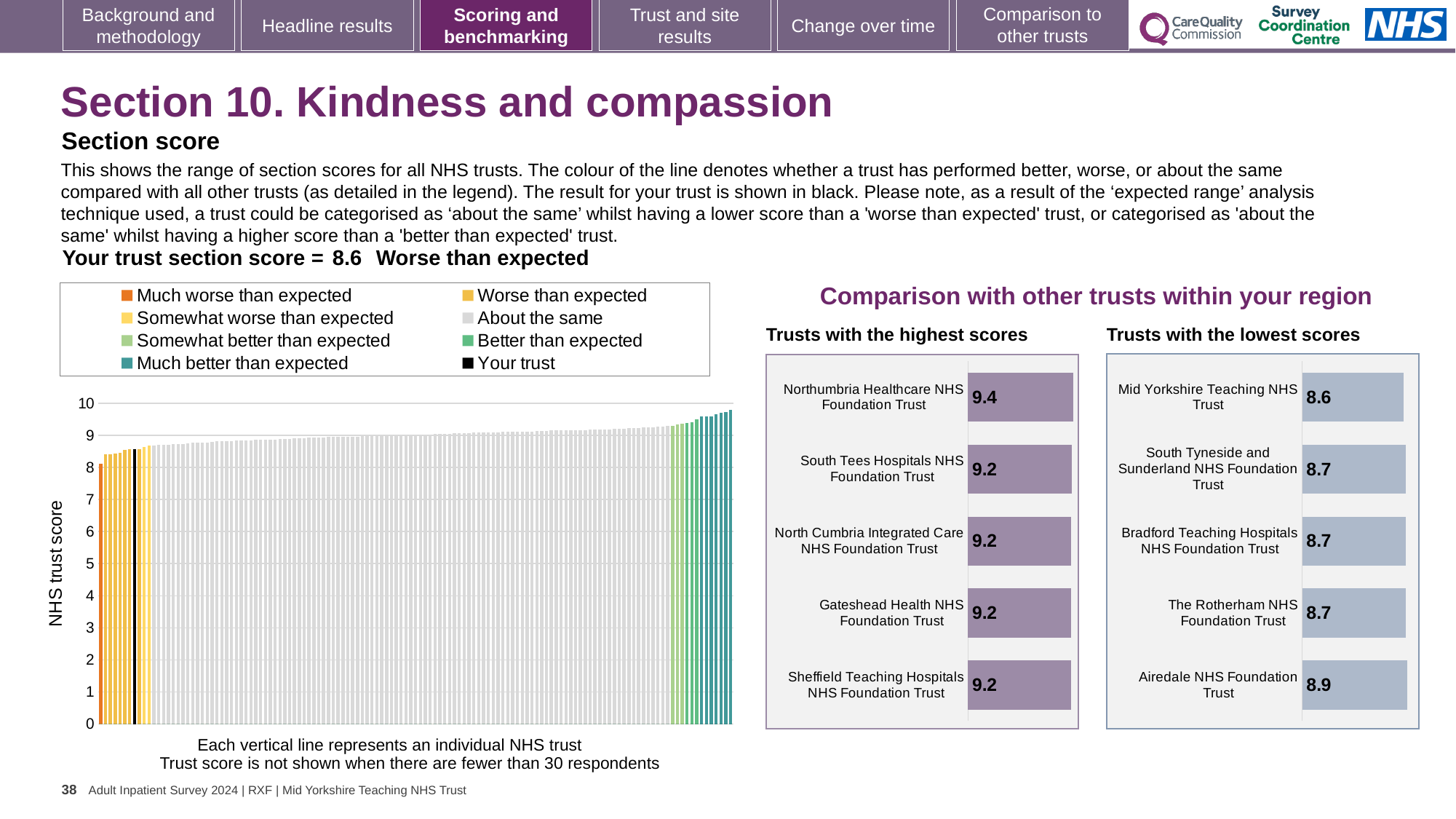
In the 'Trusts with the highest scores' chart, what is the difference between the scores of Northumbria Healthcare NHS Foundation Trust and South Tees Hospitals NHS Foundation Trust? 0.2 In the 'Trusts with the lowest scores' chart, which trust has the lowest score? Mid Yorkshire Teaching NHS Trust In the 'Trusts with the lowest scores' chart, what is the score for Airedale NHS Foundation Trust? 8.9 In the 'Trusts with the lowest scores' chart, which has the larger score: Airedale NHS Foundation Trust or Mid Yorkshire Teaching NHS Trust? Airedale NHS Foundation Trust In the main NHS trust score chart on the left, is the value for the black 'Your trust' bar greater or less than 8? greater In the main NHS trust score chart on the left, do the values rise or fall from left to right? Rise In the 'Trusts with the highest scores' chart, what is the score for Northumbria Healthcare NHS Foundation Trust? 9.4 In the 'Trusts with the lowest scores' chart, what is the difference between the scores of Airedale NHS Foundation Trust and Mid Yorkshire Teaching NHS Trust? 0.3 In the 'Trusts with the highest scores' chart, which trust has the highest score? Northumbria Healthcare NHS Foundation Trust How many entries does the legend of the main NHS trust score chart list? 8 What kind of chart is the main chart showing the NHS trust scores on the left of the slide? Bar chart How many trusts are shown in the 'Trusts with the highest scores' chart? 5